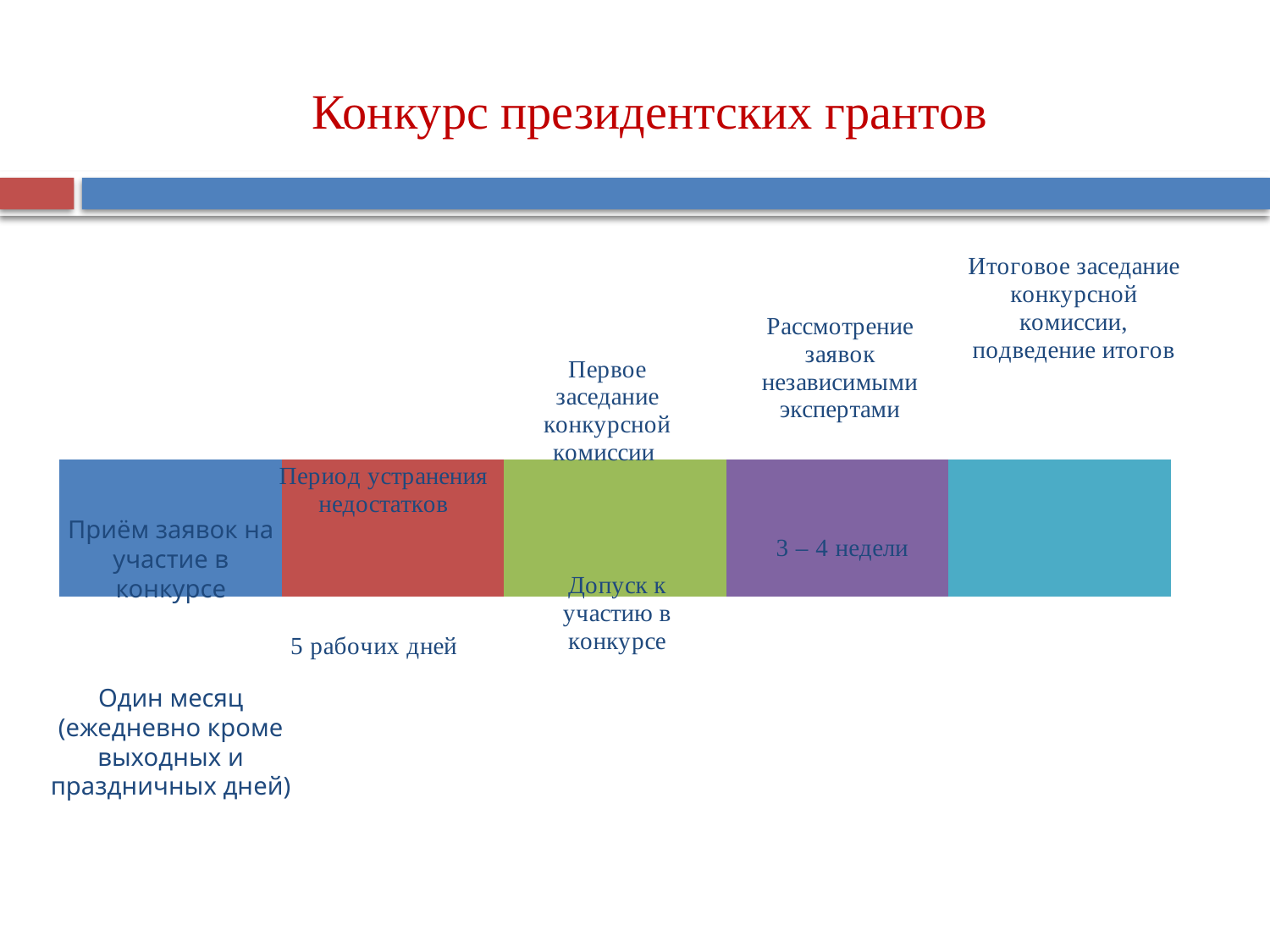
What is the title of the slide containing the timeline? Конкурс президентских грантов What is the label of the first (leftmost, blue) stage of the timeline? Приём заявок на участие в конкурсе What is the label of the last (rightmost, teal) stage of the timeline? Итоговое заседание конкурсной комиссии, подведение итогов How many coloured stages does the timeline bar on the slide contain? 5 What duration is shown inside the purple segment for 'Рассмотрение заявок независимыми экспертами'? 3 – 4 недели What colour is the segment labelled 'Период устранения недостатков'? Red What duration is given for the stage 'Период устранения недостатков'? 5 рабочих дней What duration is given for the stage 'Приём заявок на участие в конкурсе'? Один месяц (ежедневно кроме выходных и праздничных дней)